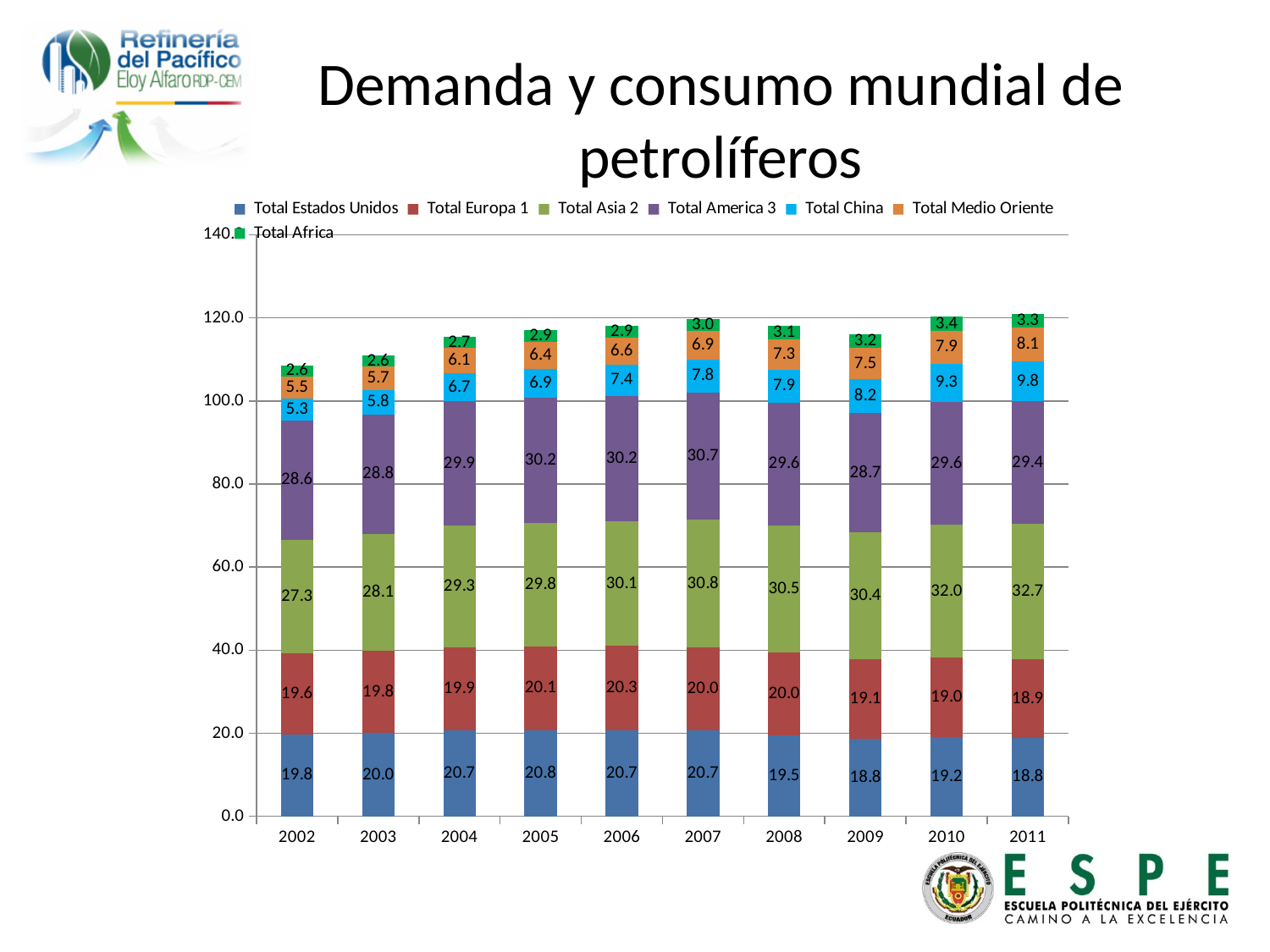
What is the total of the stacked bar for 2011? 121.0 What kind of chart is shown on the slide? Stacked bar chart What is the difference between the Total China values in 2011 and 2002? 4.5 Which is larger in 2007: Total Asia 2 or Total America 3? Total Asia 2 In which year is the Total Asia 2 value highest? 2011 What is the value for Total Medio Oriente in 2011? 8.1 What is the value for Total Estados Unidos in 2005? 20.8 How many series does the legend list? 7 How many years are shown on the x axis? 10 In which year is the Total Asia 2 value lowest? 2002 Does the Total China value rise or fall from 2002 to 2011? Rise What is the value for Total China in 2008? 7.9